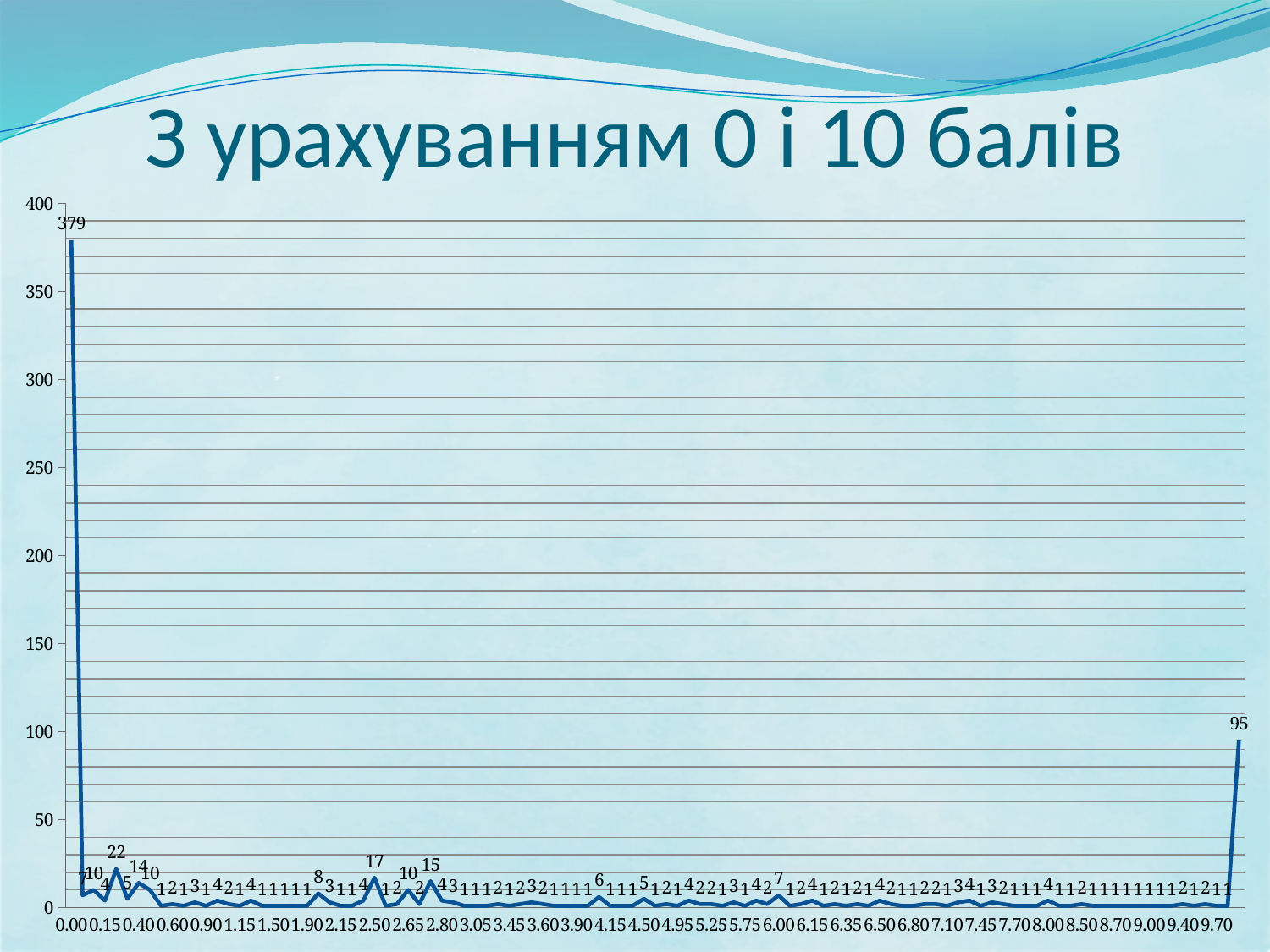
What is the maximum value shown on the vertical axis? 400 What is the value of the first point on the left, at 0.00? 379 What is the value of the last point on the far right of the chart? 95 Is the value of the last point on the right greater or less than 100? less Is the value at 0.00 greater or less than 350? greater What kind of chart is shown on the slide? line chart At which x-axis category does the line reach its highest value? 0.00 What is the highest value plotted on the chart? 379 What is the difference between the first point (379) and the last point (95)? 284 Which is larger, the value of the first point on the left or the value of the last point on the right? the first point on the left Does the line rise or fall immediately after the first point at 0.00? fall What is the title of the chart? З урахуванням 0 і 10 балів